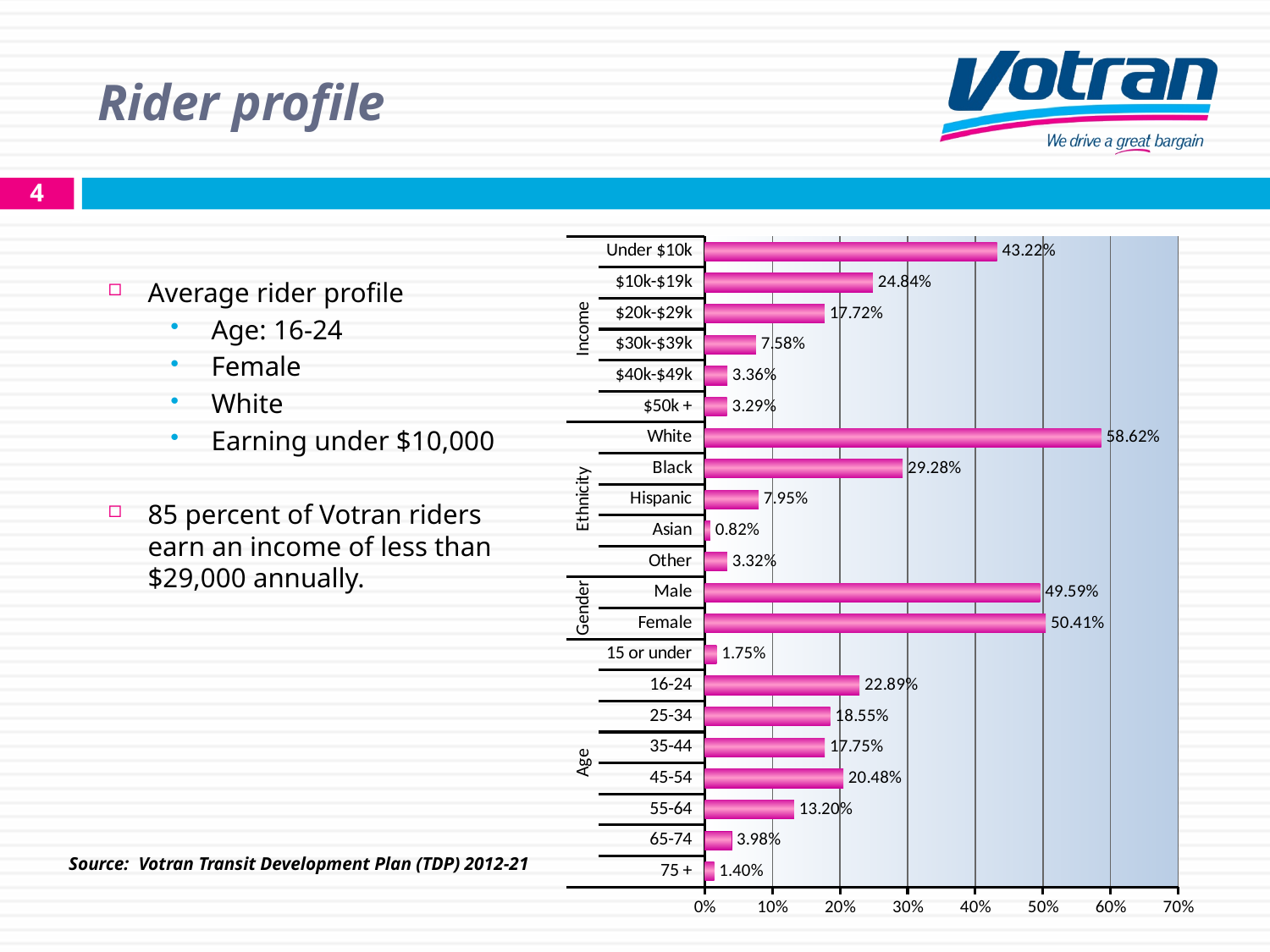
Which is larger, the value for 45-54 or the value for 55-64? 45-54 What percentage of riders are Hispanic? 7.95% Which category has the highest value in the chart? White Which category has the lowest value in the chart? Asian What is the value shown for the 16-24 age group? 22.89% Which age group has the highest percentage of riders? 16-24 What type of chart is shown on the slide? Bar chart How many bars are plotted in the chart? 21 What percentage of riders earn under $10k? 43.22% What is the difference between the Female and Male percentages? 0.82% What is the difference between the Under $10k and $10k-$19k values? 18.38% Is the value for Black greater or less than 20%? greater